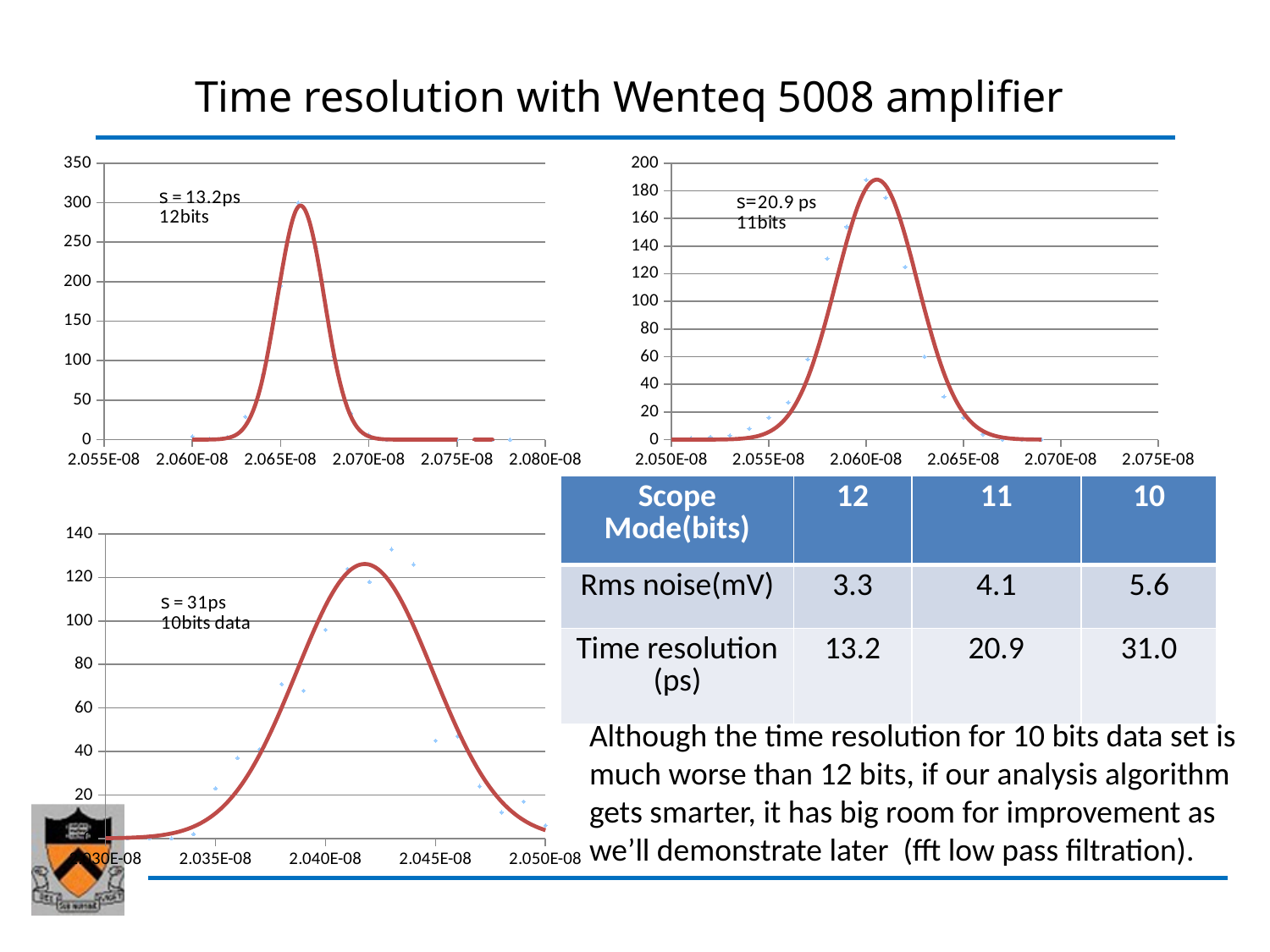
On the bottom-left chart, is the peak value of the fitted curve greater or less than 100? greater What kind of chart is the top-left chart on the slide? scatter chart with a fitted curve On the top-left chart, is the x position of the peak greater or less than 2.070E-08? less Which of the three charts has the highest peak value? the top-left chart On the bottom-left chart, is the peak value of the fitted curve greater or less than 140? less What time resolution (s) is annotated on the top-left chart? s = 13.2ps How many charts are shown on the slide? 3 What scope bit depth is annotated on the bottom-left chart? 10bits data Which chart has a higher peak, the top-right chart or the bottom-left chart? the top-right chart